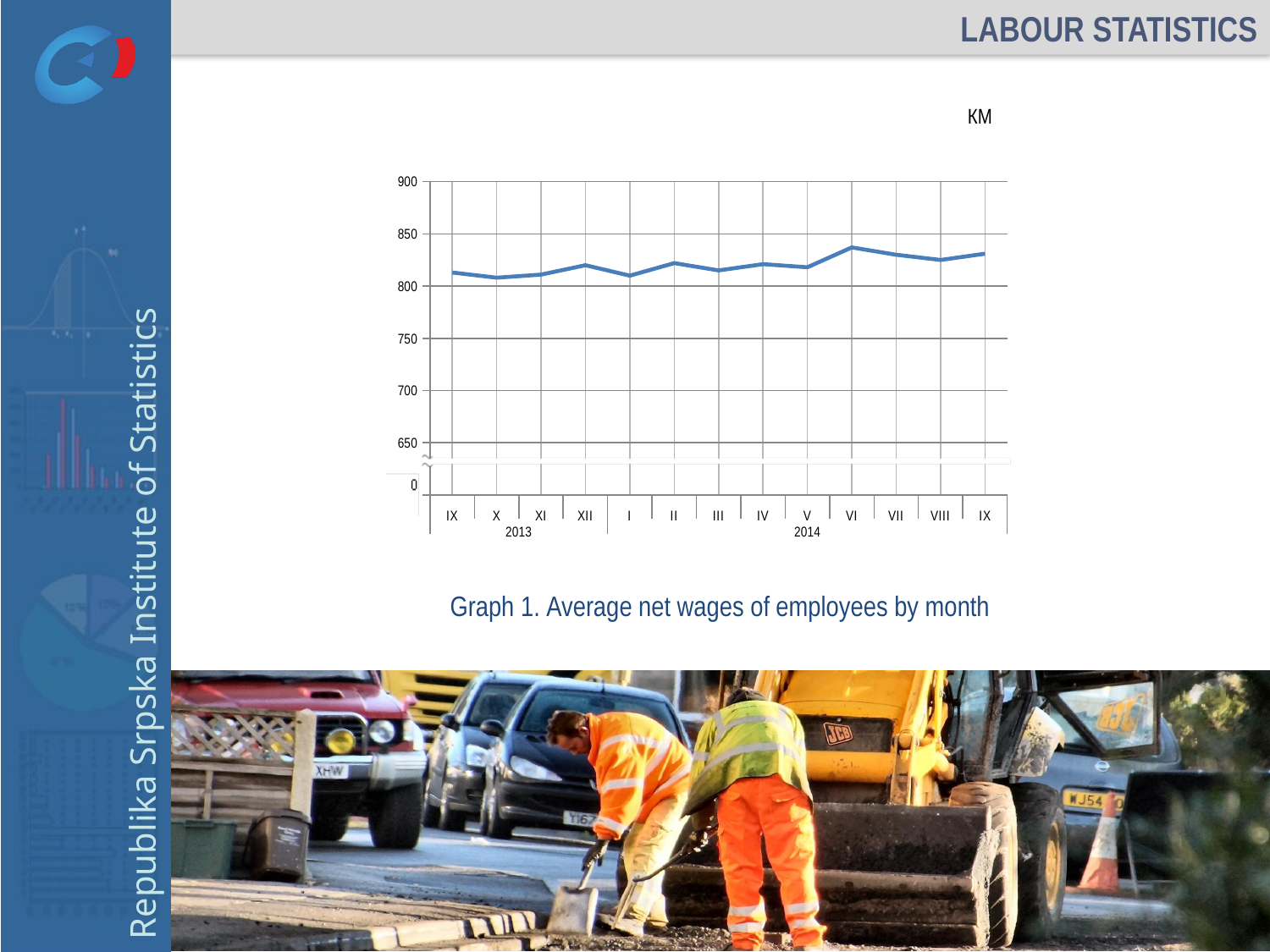
What is the title of the chart on the slide? Graph 1. Average net wages of employees by month Which is larger, the value for I 2014 or the value for VI 2014? VI 2014 What unit is shown above the chart for the plotted values? KM Overall, do the average net wages rise or fall from IX 2013 to IX 2014? rise Which month has the highest average net wage on the chart? VI 2014 Which is larger, the value for VI 2014 or the value for X 2013? VI 2014 Is the value for VI 2014 greater or less than 850? less Is the value for IX 2014 greater or less than 850? less How many monthly data points are plotted on the chart? 13 Is the value for X 2013 greater or less than 800? greater What kind of chart is shown on the slide? line chart